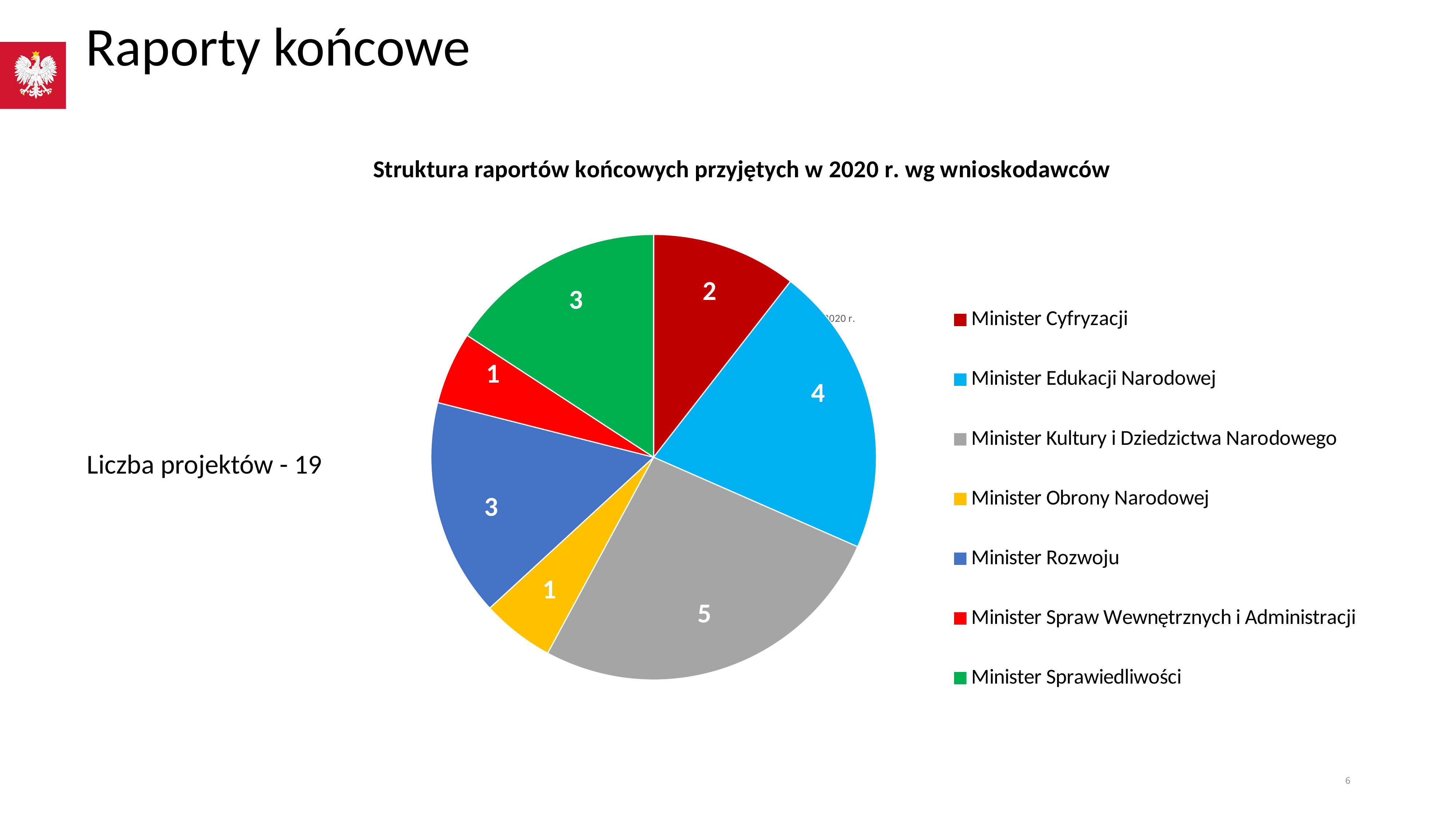
How many categories does the pie chart have? 7 What is the difference between the values for Minister Kultury i Dziedzictwa Narodowego and Minister Cyfryzacji? 3 What is the total of all the slices in the pie chart? 19 Which categories have the smallest slices of the pie? Minister Obrony Narodowej and Minister Spraw Wewnętrznych i Administracji What type of chart is shown on the slide? Pie chart What is the title of the chart? Struktura raportów końcowych przyjętych w 2020 r. wg wnioskodawców Which category has the largest slice of the pie? Minister Kultury i Dziedzictwa Narodowego What is the value for Minister Obrony Narodowej? 1 What is the value for Minister Cyfryzacji? 2 What is the value for Minister Edukacji Narodowej? 4 Which is larger, the value for Minister Edukacji Narodowej or the value for Minister Rozwoju? Minister Edukacji Narodowej What is the value for Minister Kultury i Dziedzictwa Narodowego? 5